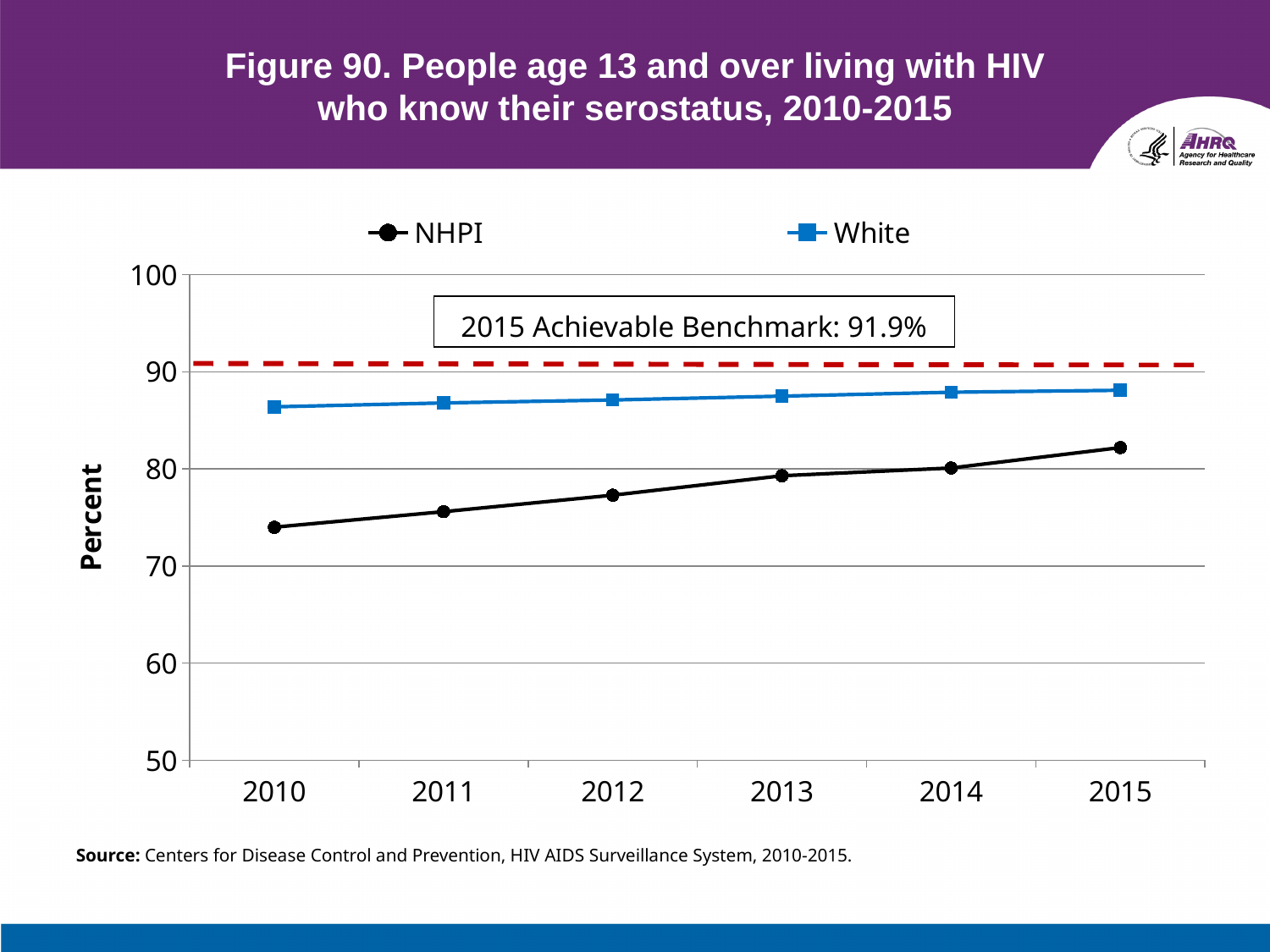
In 2010, which group has the higher value, NHPI or White? White In which year is the NHPI value lowest? 2010 Does the White line rise or fall from 2010 to 2015? rise How many years are plotted along the x axis? 6 Does the NHPI line rise or fall from 2010 to 2015? rise What kind of chart is shown on the slide? line chart In which year is the NHPI value highest? 2015 What is the 2015 Achievable Benchmark shown on the chart? 91.9% Is the value for NHPI in 2015 greater or less than 80? greater How many series does the legend list? 2 Is the value for White in 2015 greater or less than 90? less Is the value for NHPI in 2010 greater or less than 80? less